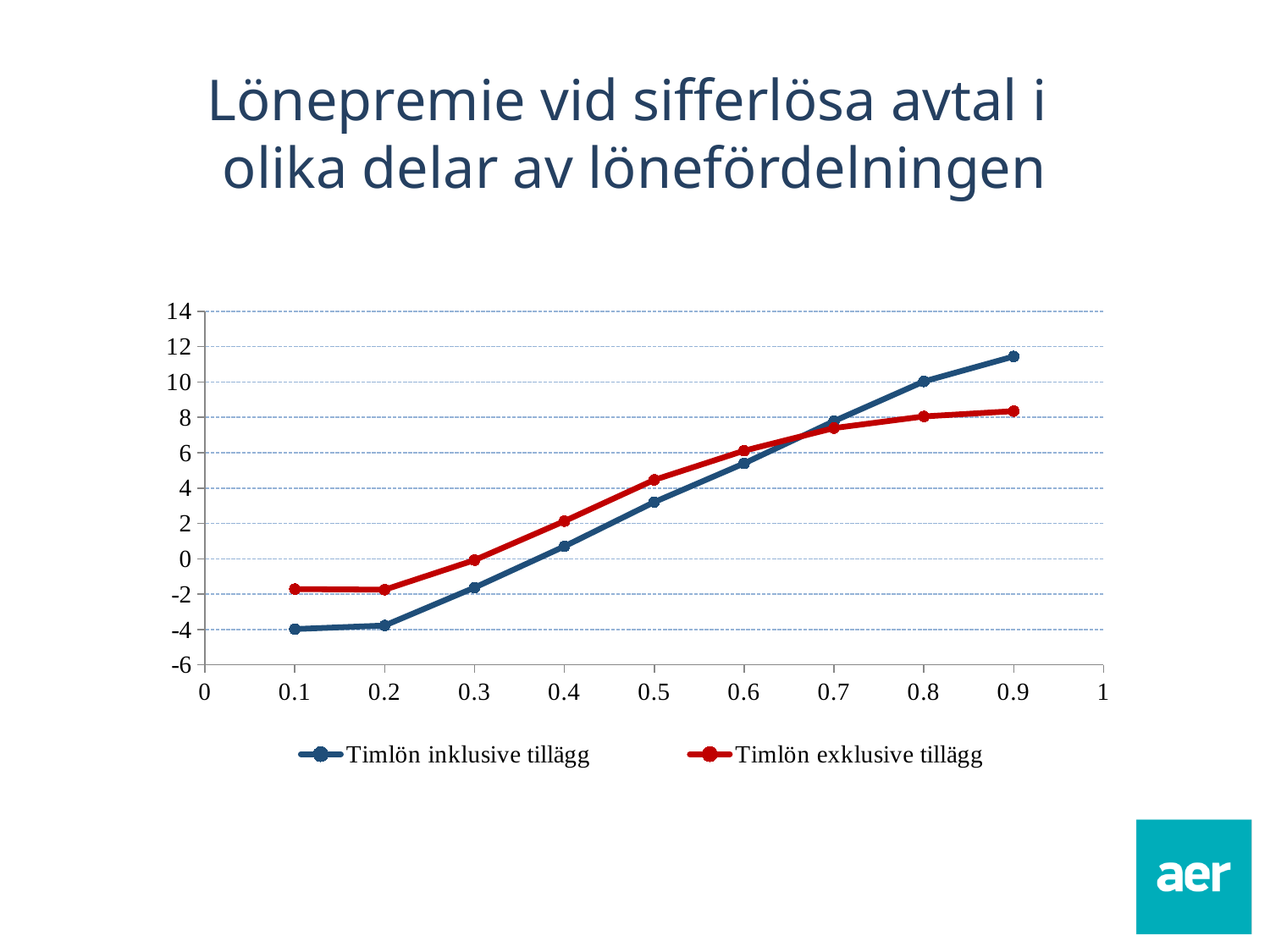
How many series does the legend list? 2 Is the value for 'Timlön inklusive tillägg' at 0.6 greater or less than 4? greater At 0.1, which series has the larger value, 'Timlön inklusive tillägg' or 'Timlön exklusive tillägg'? Timlön exklusive tillägg Is the value for 'Timlön exklusive tillägg' at 0.1 greater or less than -4? greater Is the value for 'Timlön inklusive tillägg' at 0.1 greater or less than -2? less Do the values of 'Timlön inklusive tillägg' rise or fall as the x axis goes from 0.1 to 0.9? rise What kind of chart is shown on the slide? line chart At 0.9, which series has the larger value, 'Timlön inklusive tillägg' or 'Timlön exklusive tillägg'? Timlön inklusive tillägg How many data points does the 'Timlön inklusive tillägg' line have? 9 What colour is the line for 'Timlön exklusive tillägg'? red